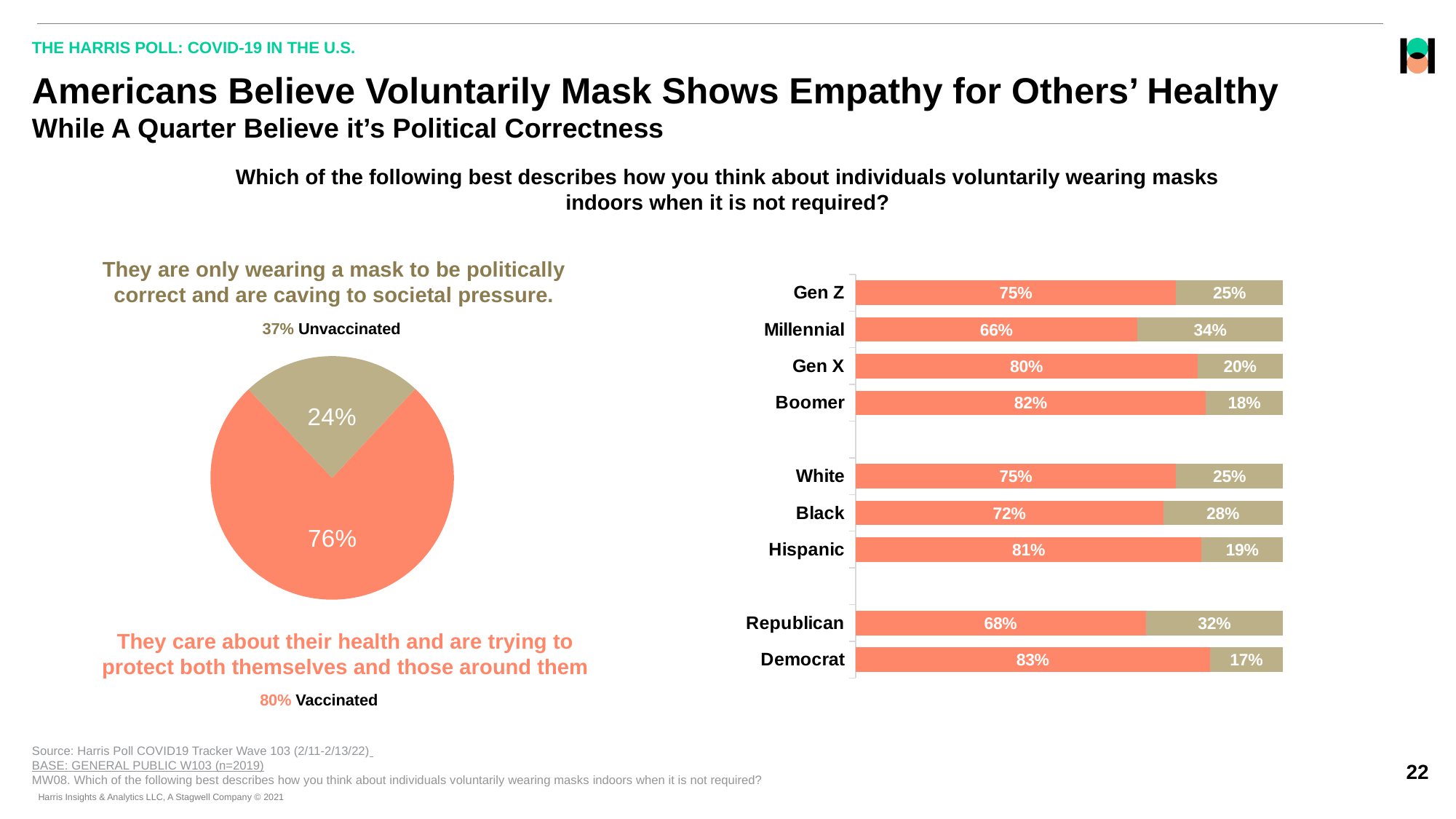
In the bar chart on the right, what is the total of the two segments for the Boomer bar? 100% In the bar chart on the right, which group has the lowest share saying mask wearers care about their health? Millennial In the bar chart on the right, which group has a larger share saying mask wearers care about their health, Gen X or Gen Z? Gen X In the bar chart on the right, what percentage of Democrats say mask wearers care about their health? 83% What kind of chart is shown on the left side of the slide? Pie chart How many demographic groups are shown in the bar chart on the right? 9 In the bar chart on the right, what is the difference between the Democrat and Republican shares saying mask wearers care about their health? 15 percentage points In the pie chart on the left, what share of respondents say people are only wearing a mask to be politically correct? 24% What kind of chart is shown on the right side of the slide? Bar chart In the bar chart on the right, which group has the highest share saying mask wearers care about their health? Democrat In the pie chart on the left, what share of respondents say people wearing masks care about their health and are trying to protect themselves and others? 76% In the bar chart on the right, what percentage of Millennials say mask wearers are only being politically correct? 34%